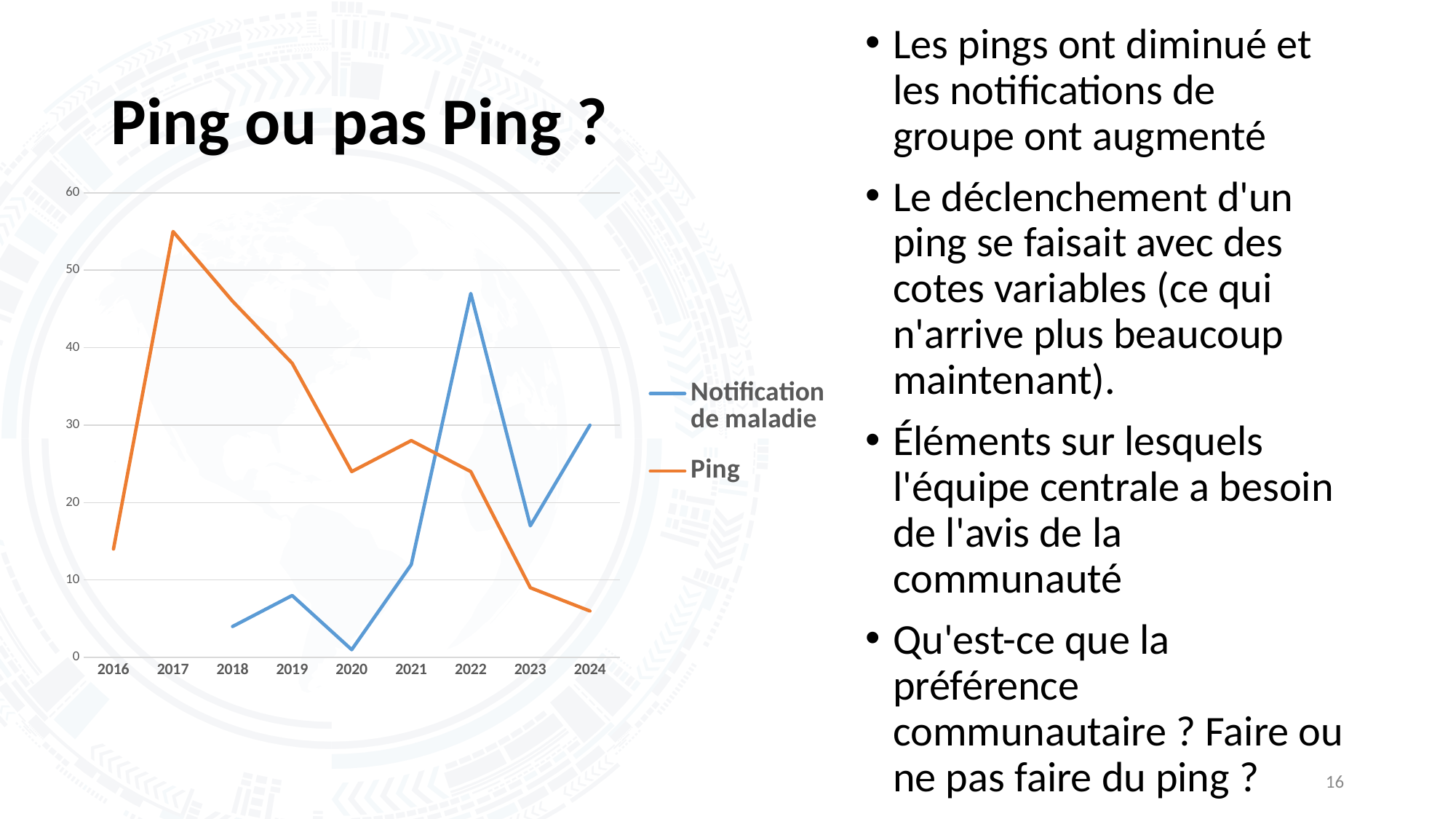
What kind of chart is shown on the slide? line chart Does the Ping series rise or fall overall from 2017 to 2024? fall Is the value for Ping in 2017 greater or less than 50? greater What colour is the line for the Ping series? orange How many years are shown on the x axis? 9 In which year does the Notification de maladie series reach its lowest value? 2020 In which year does the Notification de maladie series reach its highest value? 2022 Is the value for Notification de maladie in 2022 greater or less than 40? greater How many series does the legend list? 2 In which year does the Ping series reach its highest value? 2017 In 2022, which series has the larger value, Notification de maladie or Ping? Notification de maladie In which year does the Ping series reach its lowest value? 2024